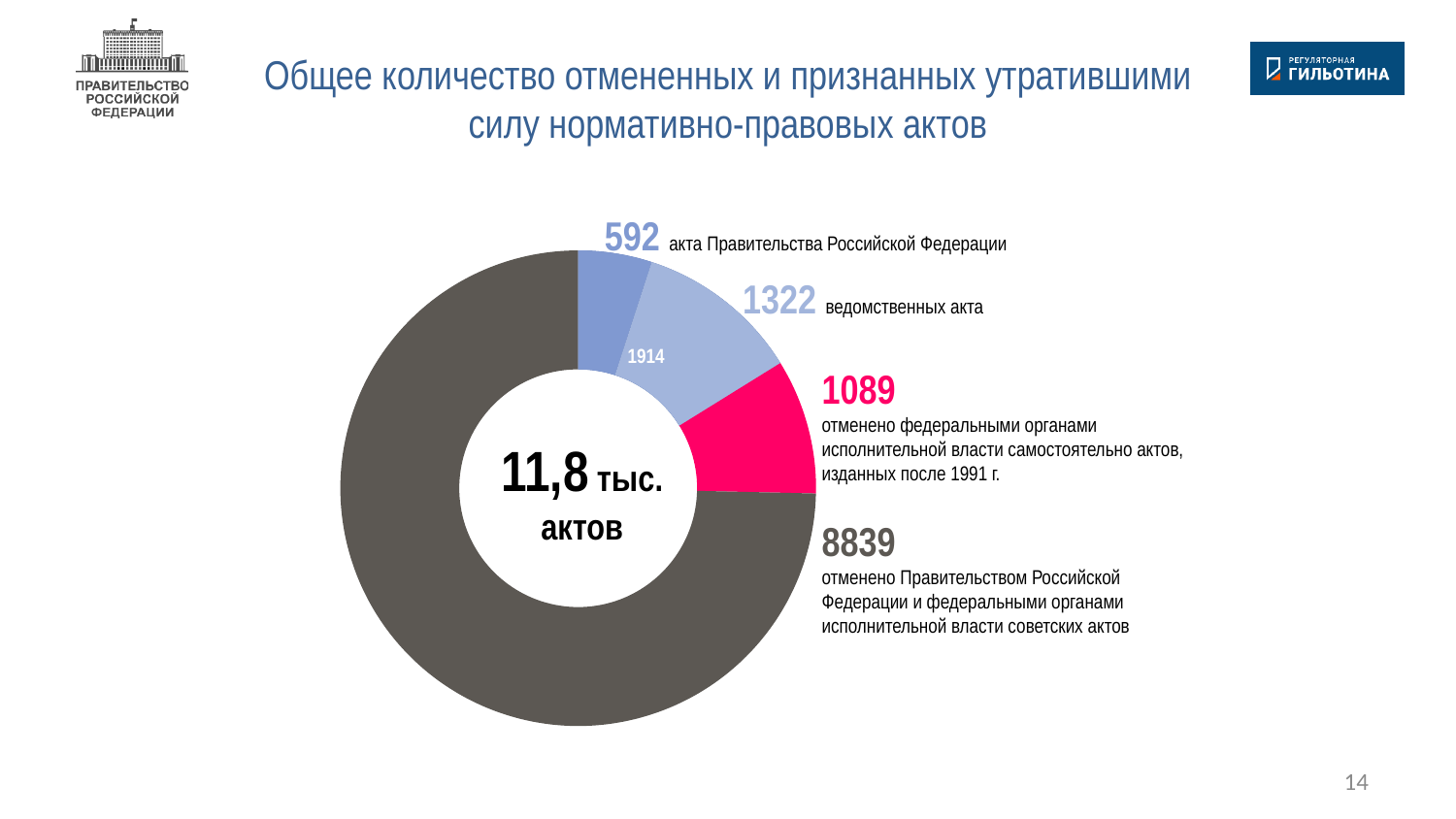
How many segments does the donut chart have? 4 How many acts issued after 1991 were cancelled independently by federal executive bodies? 1089 How many acts of the Government of the Russian Federation (акта Правительства Российской Федерации) are shown? 592 Which is larger: the number of departmental acts or the number of acts of the Government of the Russian Federation? Departmental acts (1322) What total is shown in the centre of the donut chart? 11,8 тыс. актов What is the difference between the Soviet acts segment (8839) and the post-1991 acts segment (1089)? 7750 What type of chart is shown on the slide? Donut (pie) chart Which segment of the chart has the smallest value? 592 (acts of the Government of the Russian Federation) Which segment of the chart has the largest value? 8839 (Soviet acts cancelled by the Government and federal executive bodies) What value is shown for departmental acts (ведомственных акта)? 1322 What number is printed inside the light blue part of the donut chart? 1914 What value is shown for Soviet acts cancelled by the Government of the Russian Federation and federal executive bodies? 8839